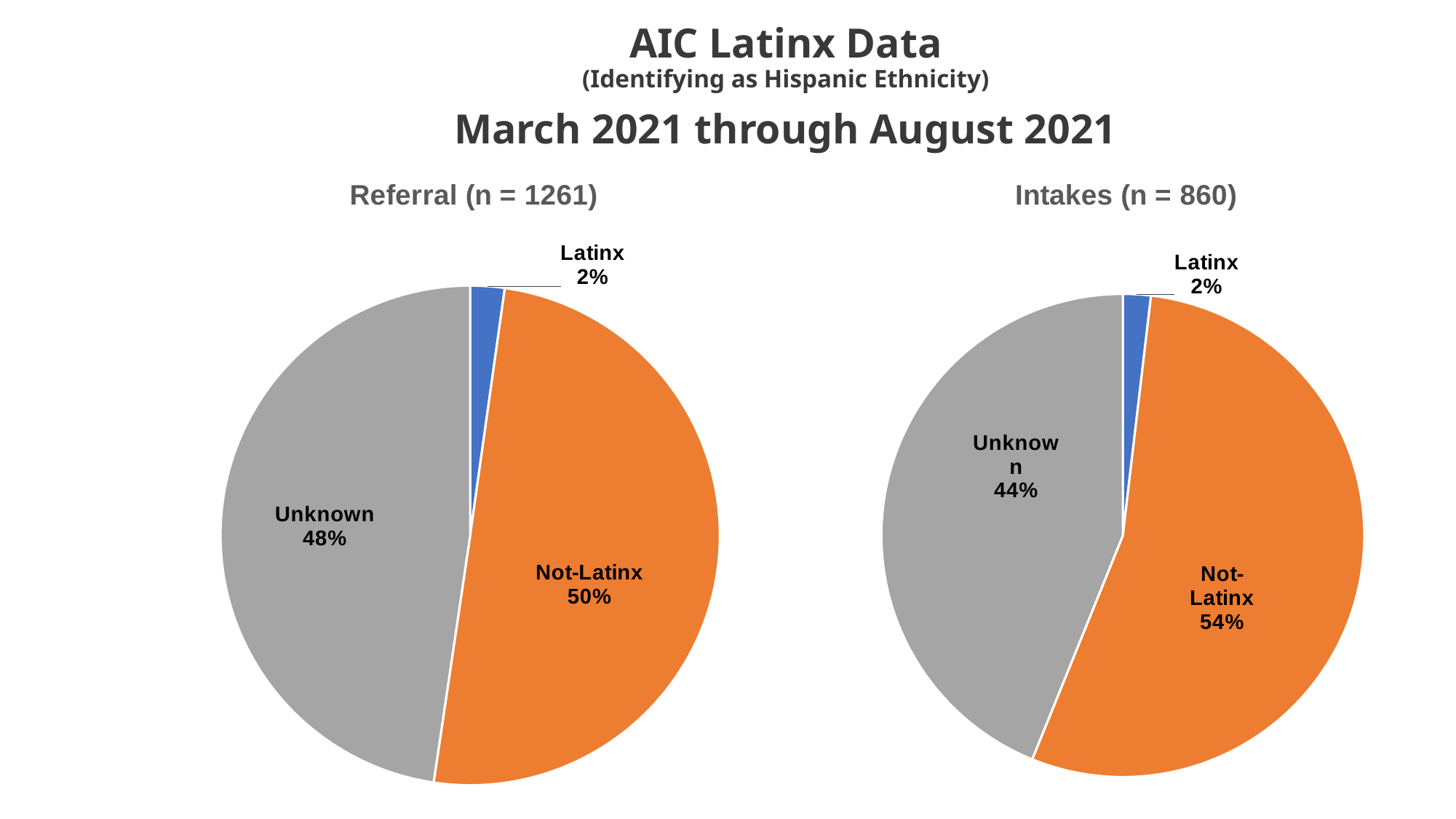
Is the Unknown share larger in the Referral (n = 1261) chart or the Intakes (n = 860) chart? Referral (n = 1261) In the Intakes (n = 860) pie chart, what share is Latinx? 2% In the Referral (n = 1261) pie chart, what colour is the Unknown slice? Gray In the Intakes (n = 860) pie chart, which category has the largest slice? Not-Latinx In the Referral (n = 1261) pie chart, which category has the smallest slice? Latinx What is the sample size shown in the title of the Intakes chart? 860 In the Intakes (n = 860) pie chart, what share is Not-Latinx? 54% In the Intakes (n = 860) pie chart, what is the difference between the Not-Latinx and Unknown shares? 10% In the Referral (n = 1261) pie chart, what share is Not-Latinx? 50% How many slices does the Referral (n = 1261) pie chart have? 3 What type of chart is used for the Intakes (n = 860) data? Pie chart In the Referral (n = 1261) pie chart, what share is Unknown? 48%